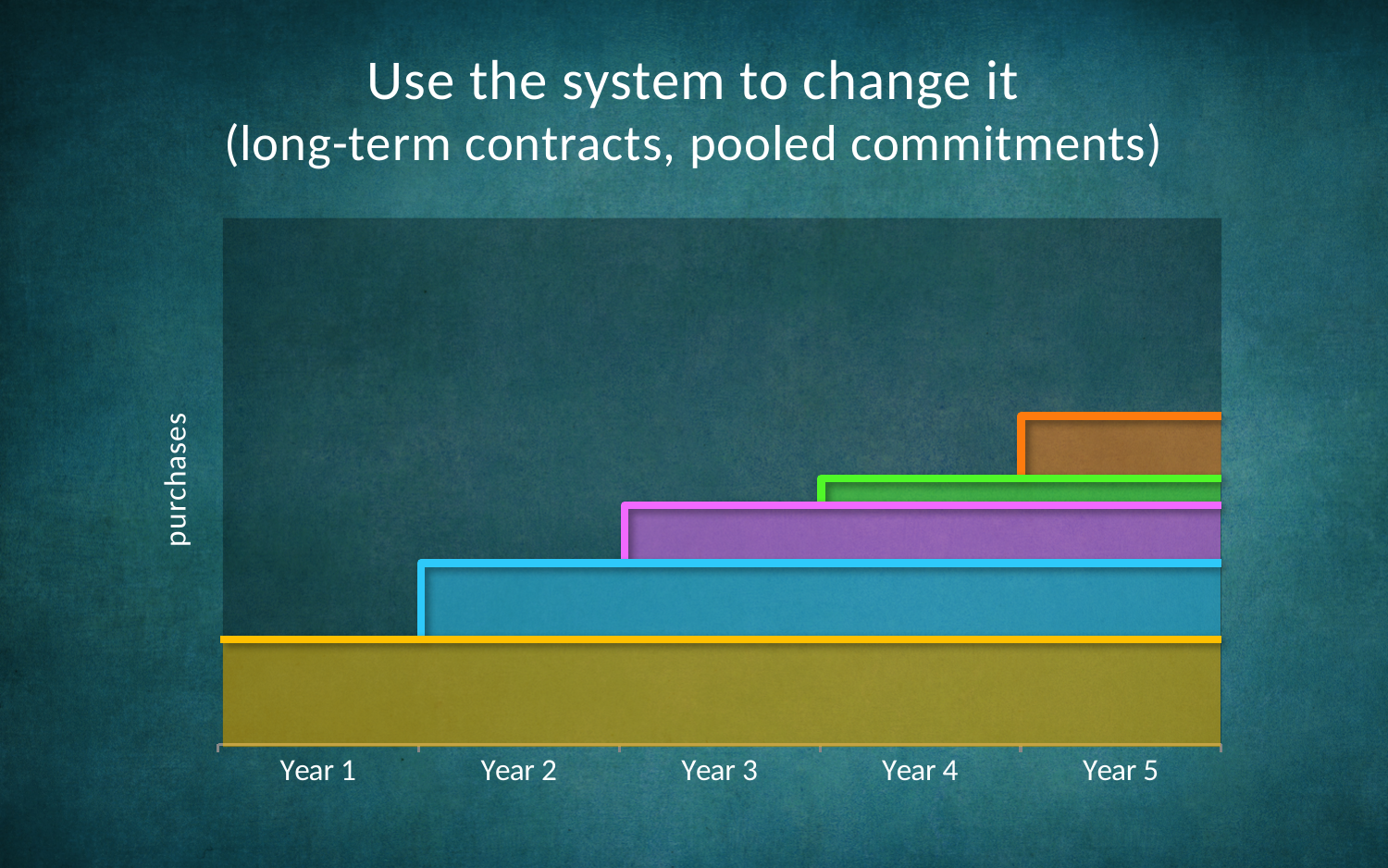
Which year has the lowest total purchases? Year 1 What is the title of the slide containing the chart? Use the system to change it (long-term contracts, pooled commitments) Which is larger, the total for Year 2 or the total for Year 4? Year 4 How many categories are shown on the x axis of the chart? 5 Which is larger, the total for Year 1 or the total for Year 5? Year 5 Which year has the highest total purchases? Year 5 What is the label on the vertical axis of the chart? purchases How many stacked layers are shown for Year 1? 1 What kind of chart is shown on the slide? stacked bar chart Do the total purchases rise or fall from Year 1 to Year 5? rise What is the first category on the x axis? Year 1 How many stacked layers are shown for Year 5? 5